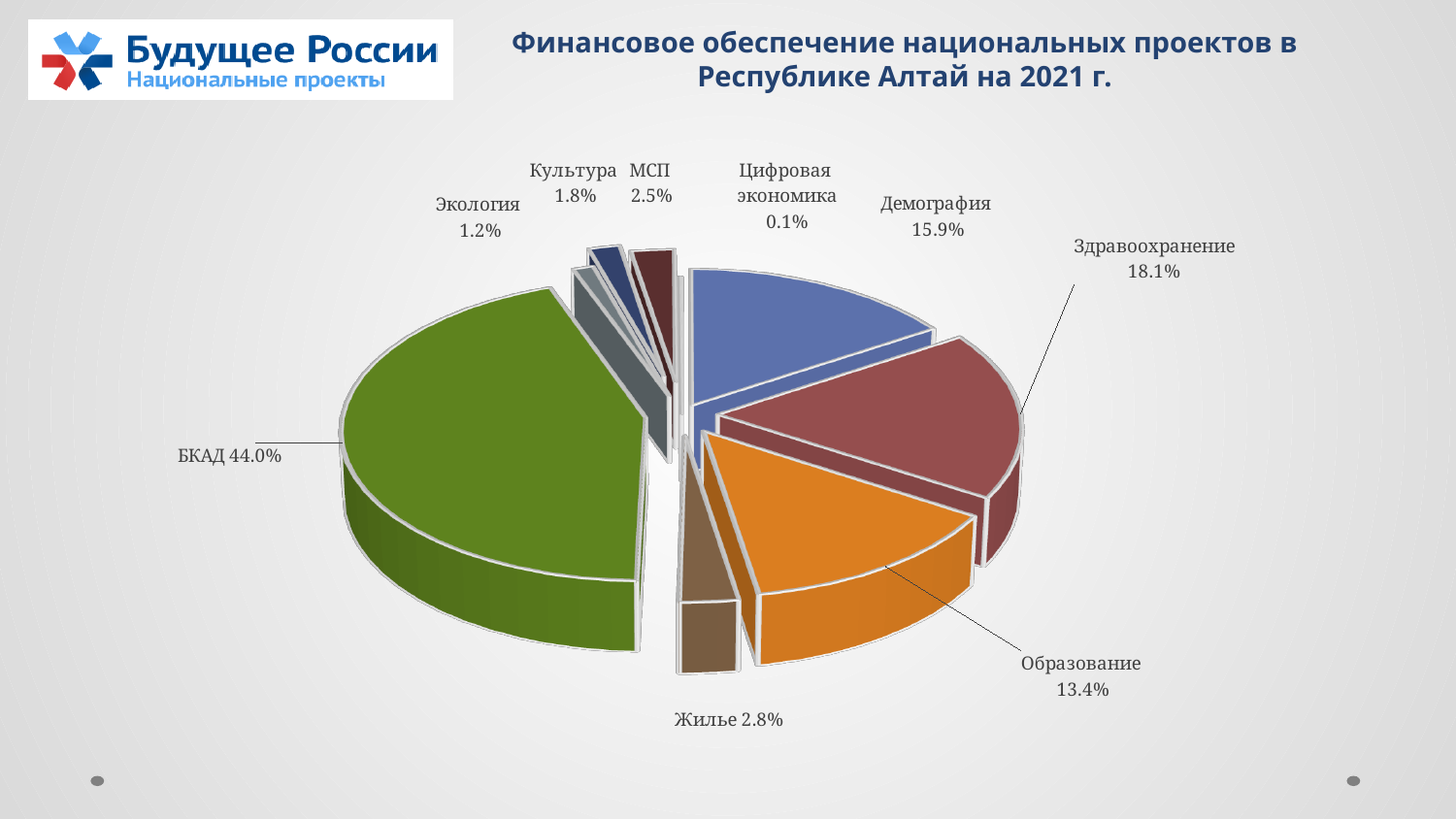
What is the value shown for Здравоохранение? 18.1% What is the title of the chart on the slide? Финансовое обеспечение национальных проектов в Республике Алтай на 2021 г. What kind of chart is shown on the slide? Pie chart How many categories are shown in the pie chart? 9 What is the value shown for Образование? 13.4% Which category has the largest share of the pie? БКАД Which is larger, the share for Здравоохранение or the share for Демография? Здравоохранение What is the difference in percentage points between Здравоохранение and Образование? 4.7 What is the value shown for Демография? 15.9% Which category has the smallest share of the pie? Цифровая экономика What is the value shown for Цифровая экономика? 0.1% What share of the pie does БКАД have? 44.0%